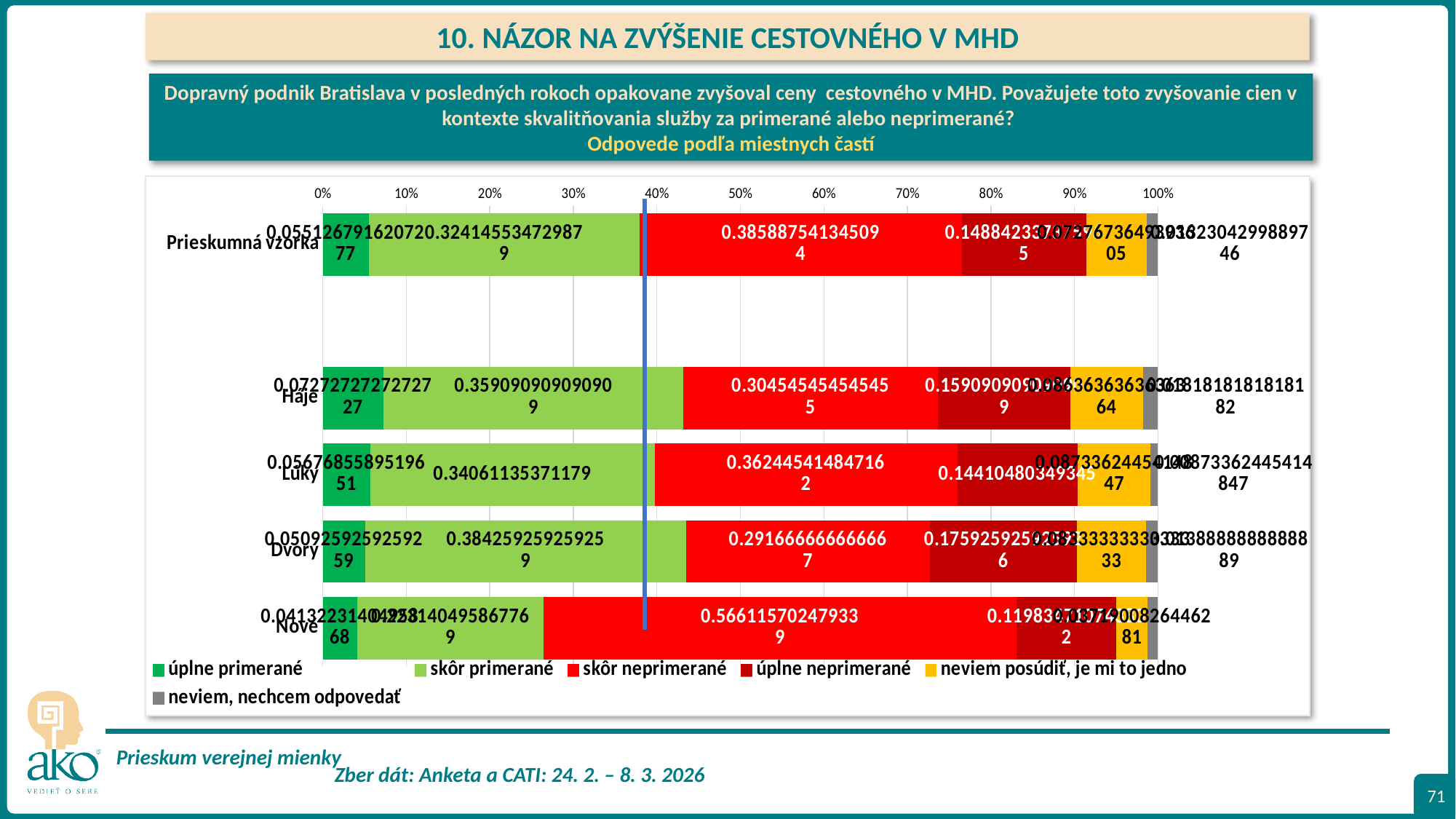
Is the 'skôr neprimerané' value for Nové greater or less than 50%? greater Which has the larger 'skôr primerané' value, Dvory or Háje? Dvory Which category has the highest value for 'skôr neprimerané'? Nové What kind of chart is shown on the slide? bar chart What is the value of 'skôr neprimerané' for Nové? 0.566115702479339 What is the value of 'skôr primerané' for Lúky? 0.34061135371179 What is the value of 'skôr neprimerané' for Lúky? 0.362445414847162 How many series does the legend list? 6 What colour represents 'skôr neprimerané' in the legend? red How many categories (rows) are plotted in the chart? 5 What is the value of 'skôr neprimerané' for Háje? 0.304545454545455 Which category has the lowest value for 'skôr neprimerané'? Dvory